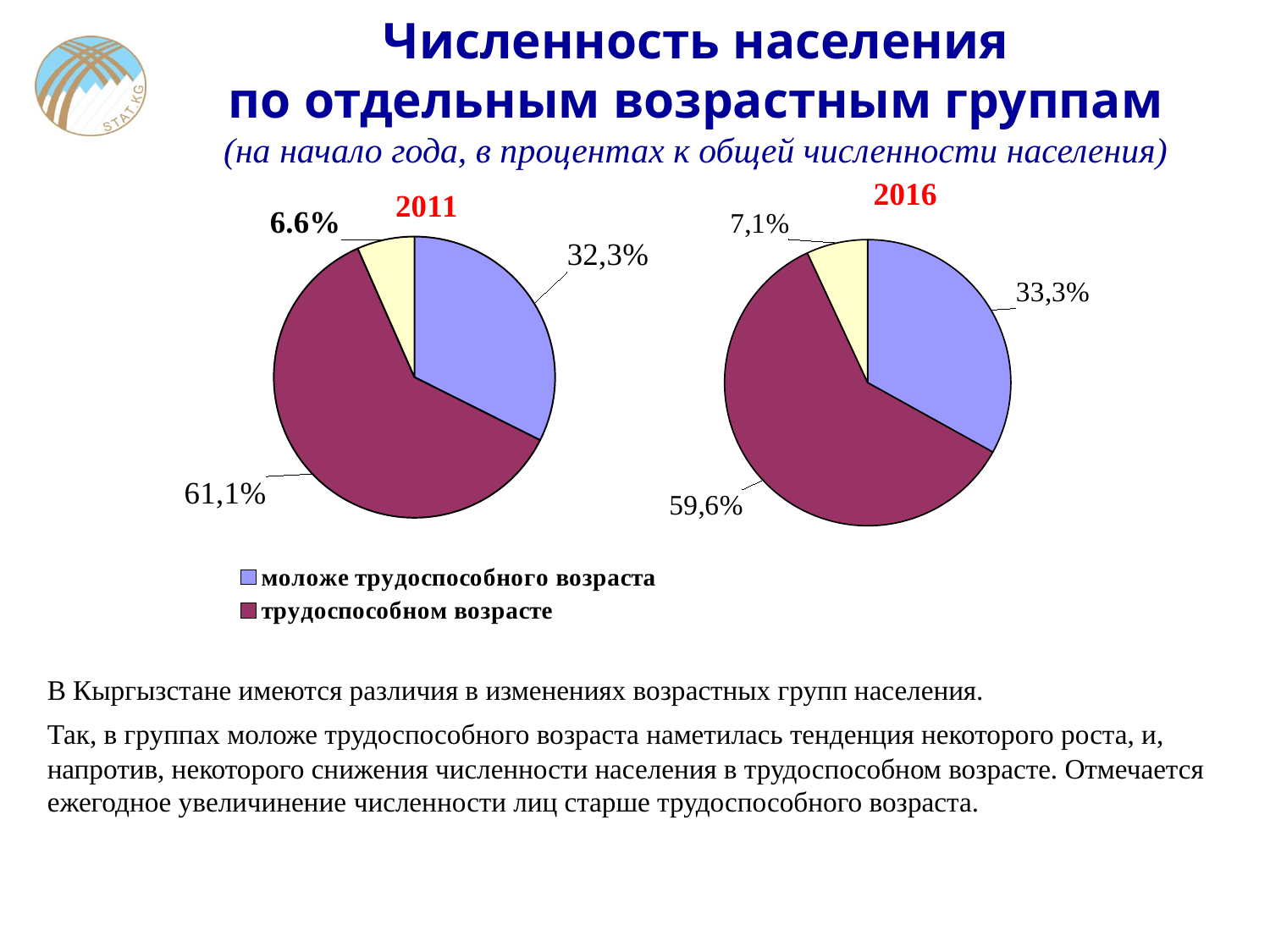
In the 2011 pie chart, what share of the population is in the 'моложе трудоспособного возраста' group? 32,3% In the 2011 pie chart, what share of the population is in the 'трудоспособном возрасте' group? 61,1% In the 2016 pie chart, what share of the population is in the 'моложе трудоспособного возраста' group? 33,3% How many entries does the legend below the charts list? 2 In the 2011 pie chart, which slice is the smallest? the yellow slice (6.6%) What type of charts are shown on the slide? pie charts In the 2016 pie chart, what value is shown for the smallest (yellow) slice? 7,1% In the 2016 pie chart, which group has the largest share? трудоспособном возрасте Which is larger: the 'моложе трудоспособного возраста' share in the 2011 chart or in the 2016 chart? 2016 By how many percentage points did the 'трудоспособном возрасте' share change from the 2011 chart to the 2016 chart? 1,5 percentage points lower In the 2011 pie chart, what value is shown for the smallest (yellow) slice? 6.6% In the 2016 pie chart, what share of the population is in the 'трудоспособном возрасте' group? 59,6%